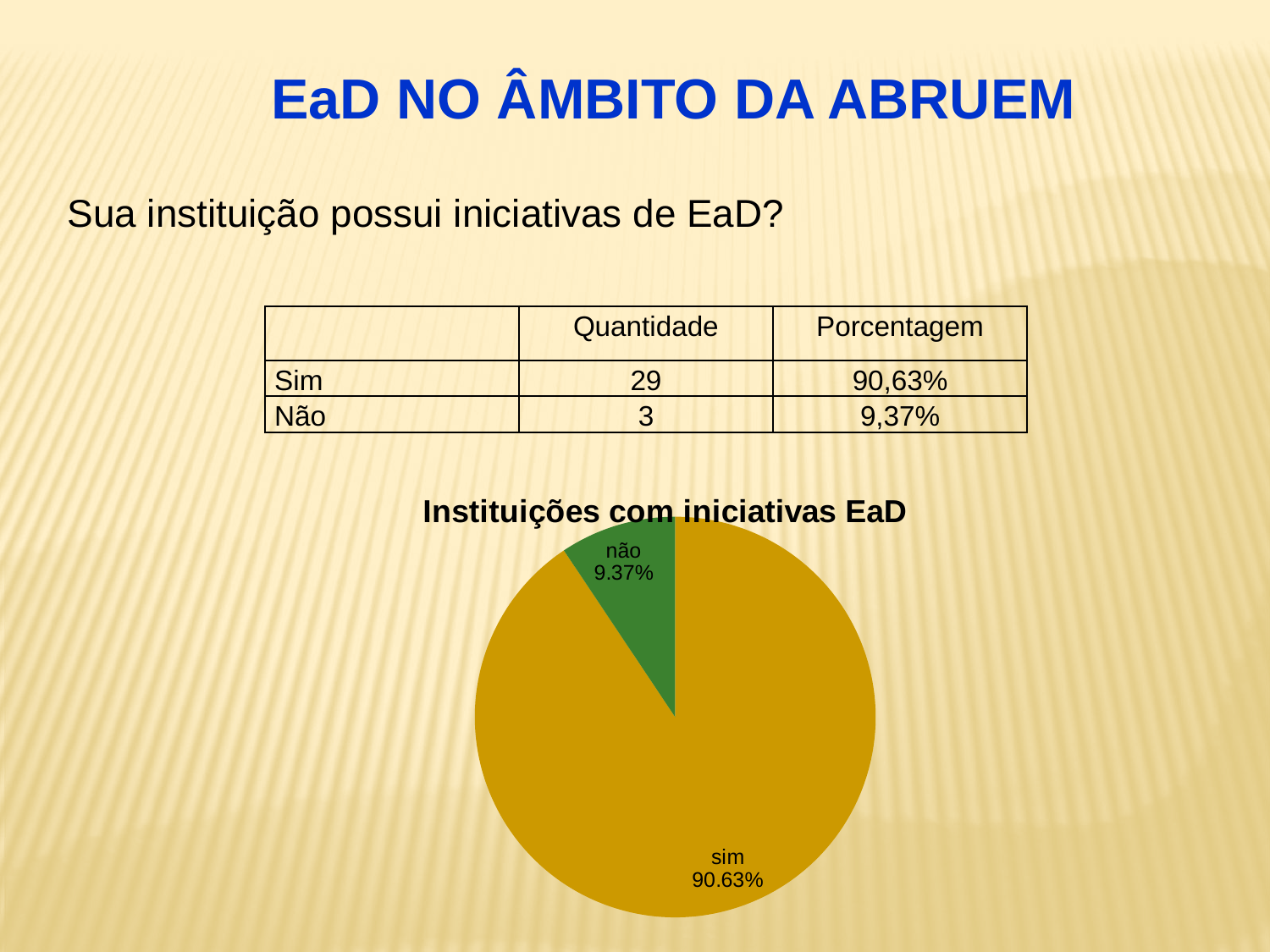
What is the difference in percentage points between the "sim" and "não" slices? 81.26 What is the title of the pie chart? Instituições com iniciativas EaD What share of the pie does the "sim" slice represent? 90.63% Which slice of the pie chart is the largest? sim What colour is the "não" slice in the pie chart? green What share of the pie does the "não" slice represent? 9.37% What kind of chart is shown on the slide? pie chart How many slices does the pie chart have? 2 Which slice of the pie chart is the smallest? não Which is larger in the pie chart, the "sim" slice or the "não" slice? sim